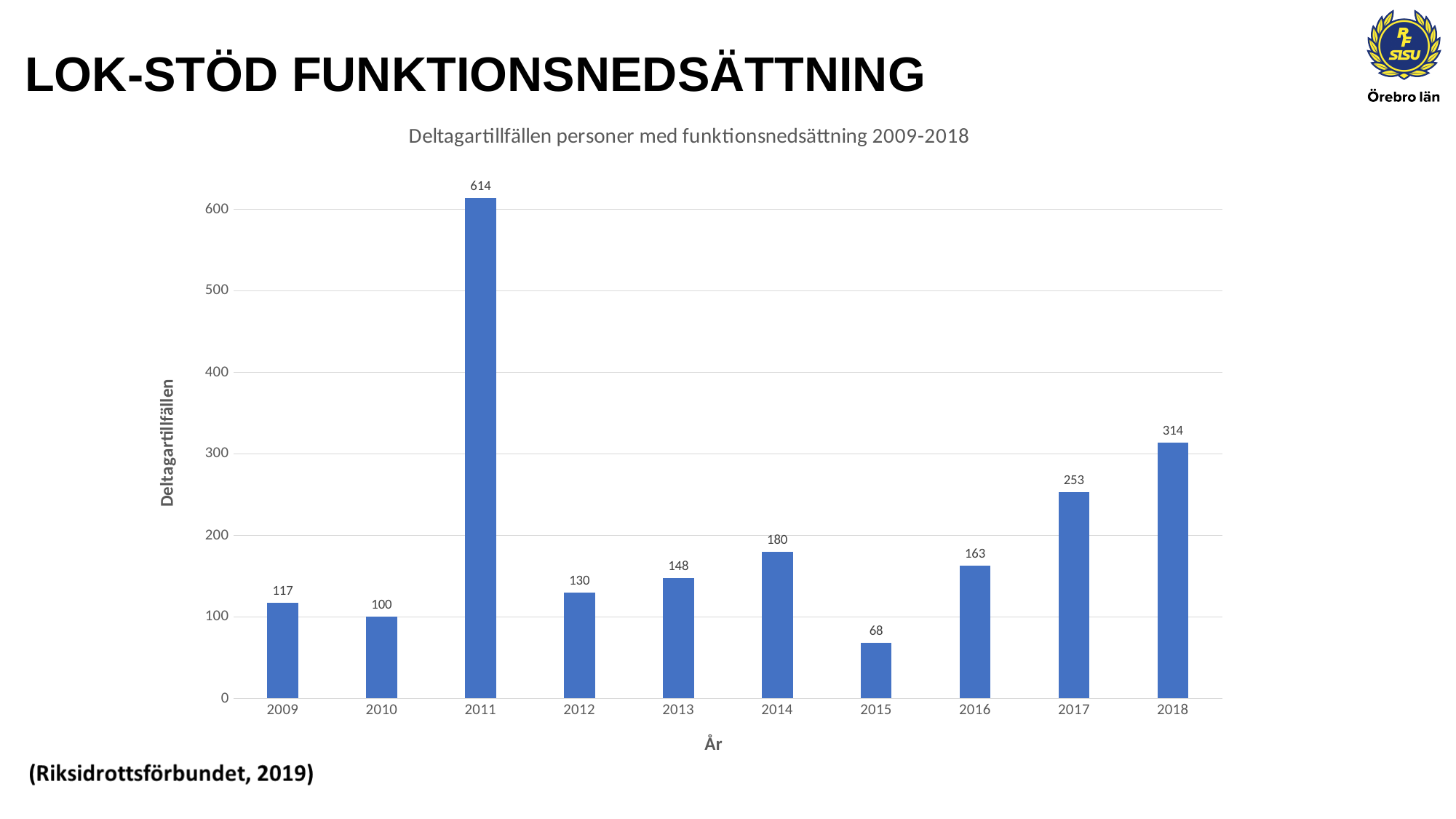
Which is larger, the value for 2013 or the value for 2016? 2016 What is the difference between the values for 2018 and 2017? 61 What kind of chart is this? bar chart Which year has the highest value? 2011 What is the value for 2015? 68 What is the value for 2018? 314 What is the title of the chart? Deltagartillfällen personer med funktionsnedsättning 2009-2018 Do the values rise or fall from 2015 to 2018? rise What is the value for 2011? 614 Is the value for 2014 greater or less than 200? less How many years are shown on the x axis? 10 Which year has the lowest value? 2015